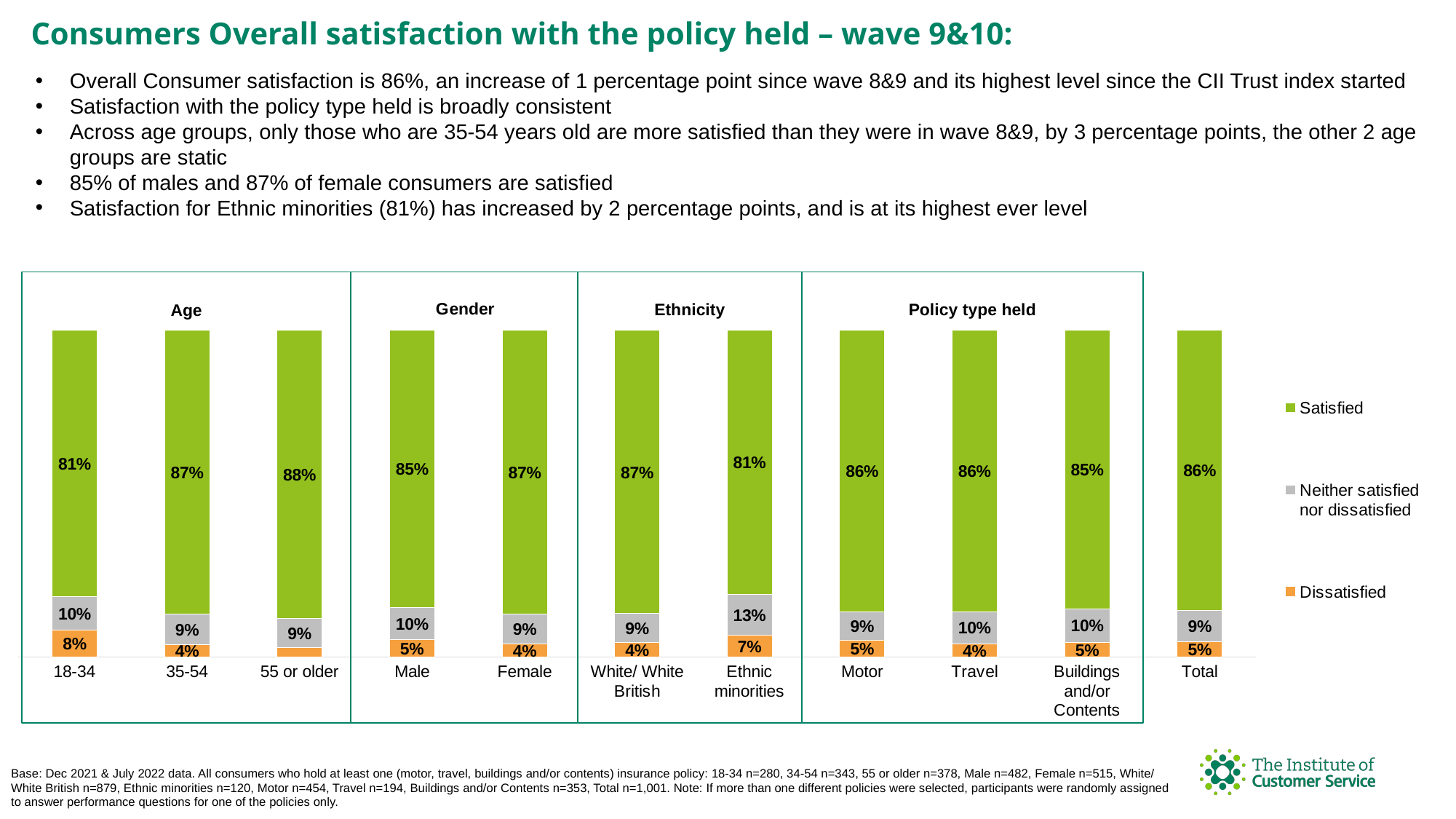
What type of chart is shown on the slide? Stacked bar chart How many categories (bars) are shown in the chart? 11 What is the 'Neither satisfied nor dissatisfied' value for Ethnic minorities? 13% What percentage of consumers aged 55 or older are satisfied? 88% Which category has the highest Dissatisfied percentage? 18-34 Which has a higher Satisfied percentage, White/ White British or Ethnic minorities? White/ White British How many series does the legend list? 3 What is the total of the three segments for the 35-54 bar? 100% What is the difference between the Satisfied percentage for Female and Male consumers? 2% What is the Satisfied value for Travel policy holders? 86% Which category has the highest Satisfied percentage? 55 or older What is the Dissatisfied value for the 18-34 age group? 8%